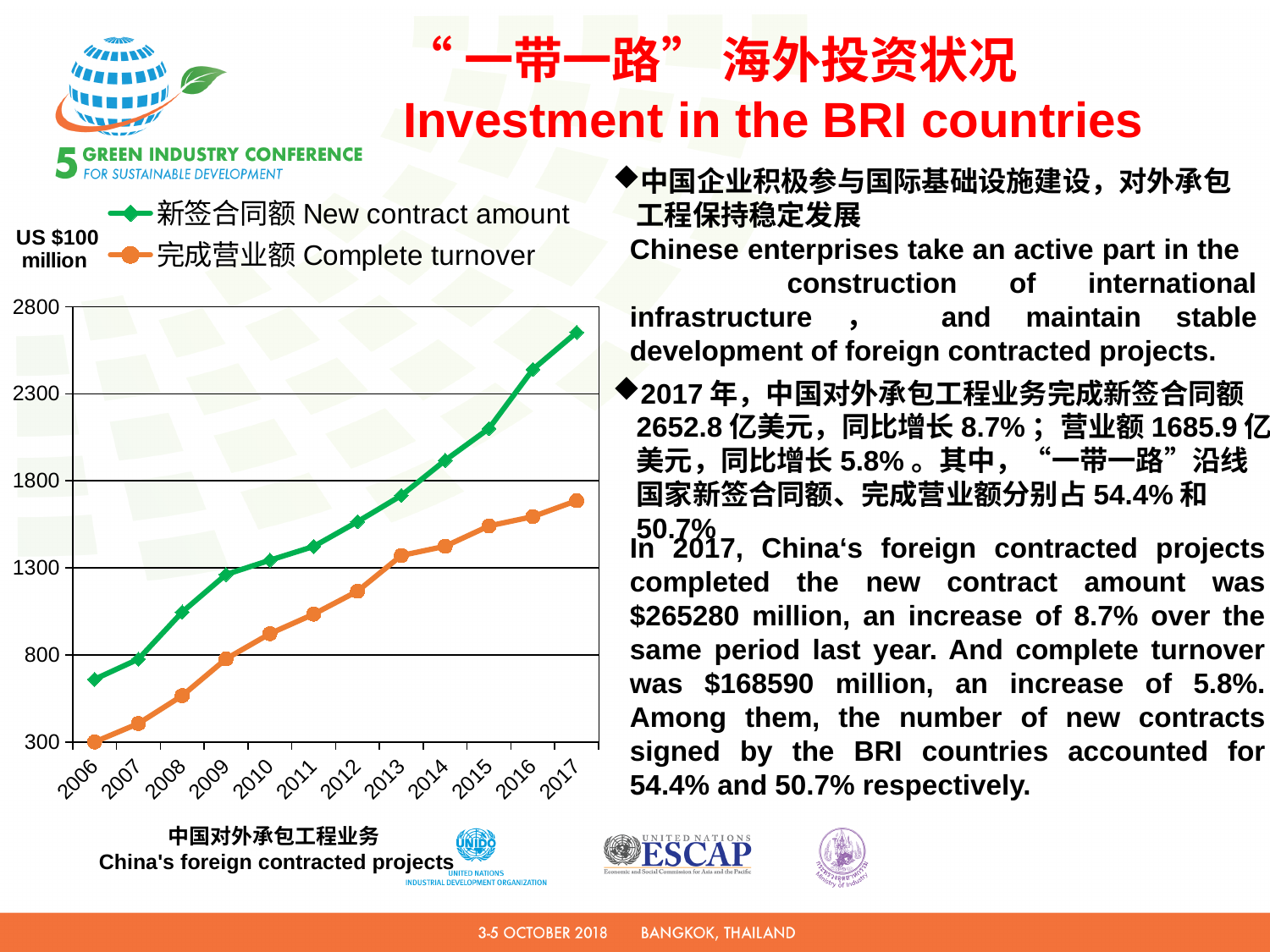
What kind of chart is shown on the slide? line chart In which year is the New contract amount highest? 2017 How many years are plotted along the x axis of the chart? 12 In 2017, which is larger: the New contract amount or the Complete turnover? New contract amount Is the New contract amount for 2006 greater or less than 800? less How many series does the chart legend list? 2 Do the New contract amount values rise or fall from 2006 to 2017? rise Is the Complete turnover for 2017 greater or less than 1800? less Is the New contract amount for 2017 greater or less than 2300? greater In which year is the Complete turnover lowest? 2006 What unit is shown for the values on the chart's y axis? US $100 million